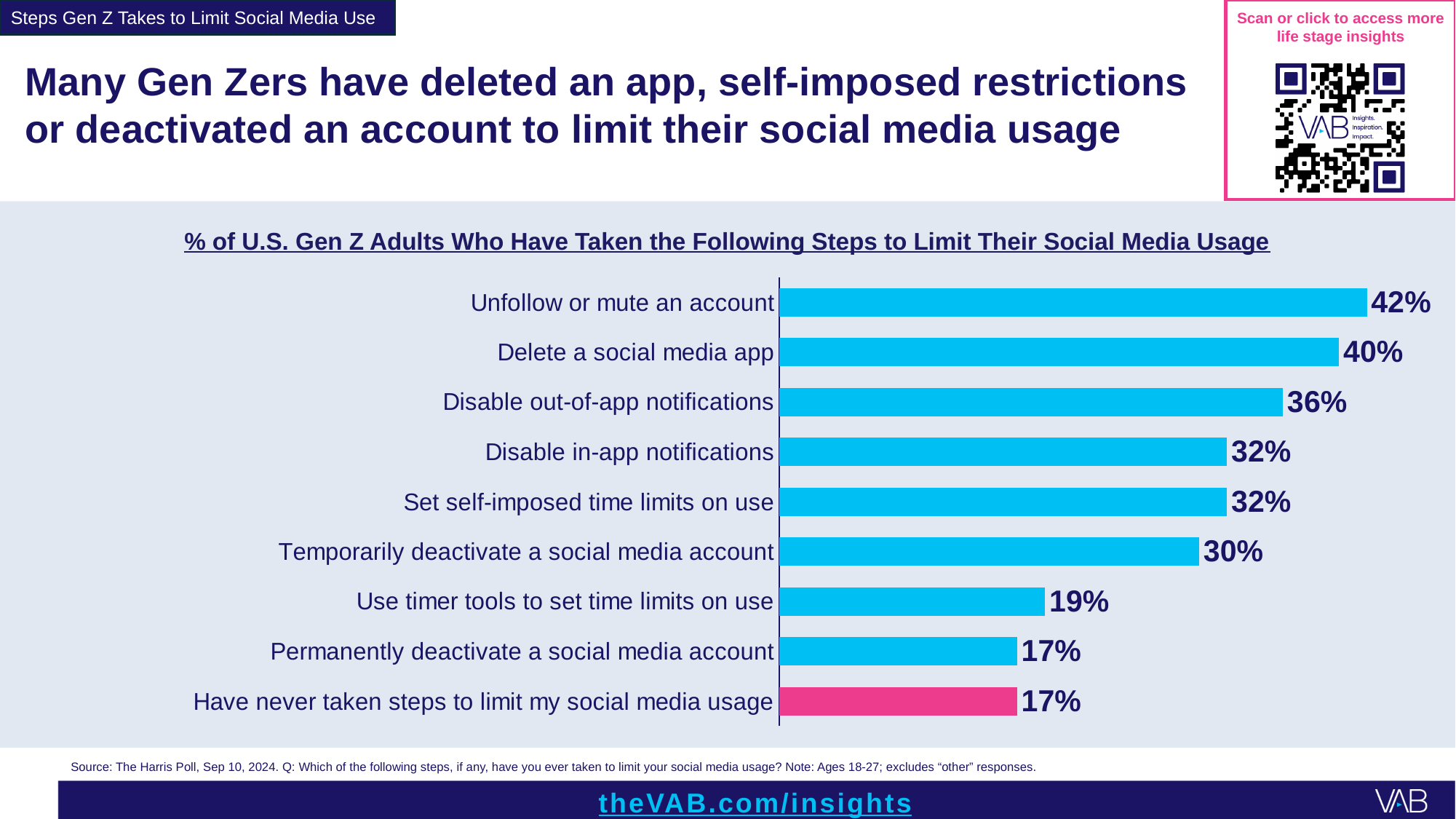
Which step has the highest percentage? Unfollow or mute an account What is the value for 'Have never taken steps to limit my social media usage'? 17% Which is larger: 'Disable out-of-app notifications' or 'Disable in-app notifications'? Disable out-of-app notifications What is the difference between 'Disable out-of-app notifications' and 'Use timer tools to set time limits on use'? 17% What percentage of Gen Z adults have unfollowed or muted an account to limit social media usage? 42% What is the difference between 'Unfollow or mute an account' and 'Delete a social media app'? 2% Which bar is shown in a different colour (pink) from the others? Have never taken steps to limit my social media usage How many categories are shown in the chart? 9 What kind of chart is shown on the slide? Bar chart Which is larger: 'Temporarily deactivate a social media account' or 'Permanently deactivate a social media account'? Temporarily deactivate a social media account What percentage have used timer tools to set time limits on use? 19% What is the value for 'Delete a social media app'? 40%